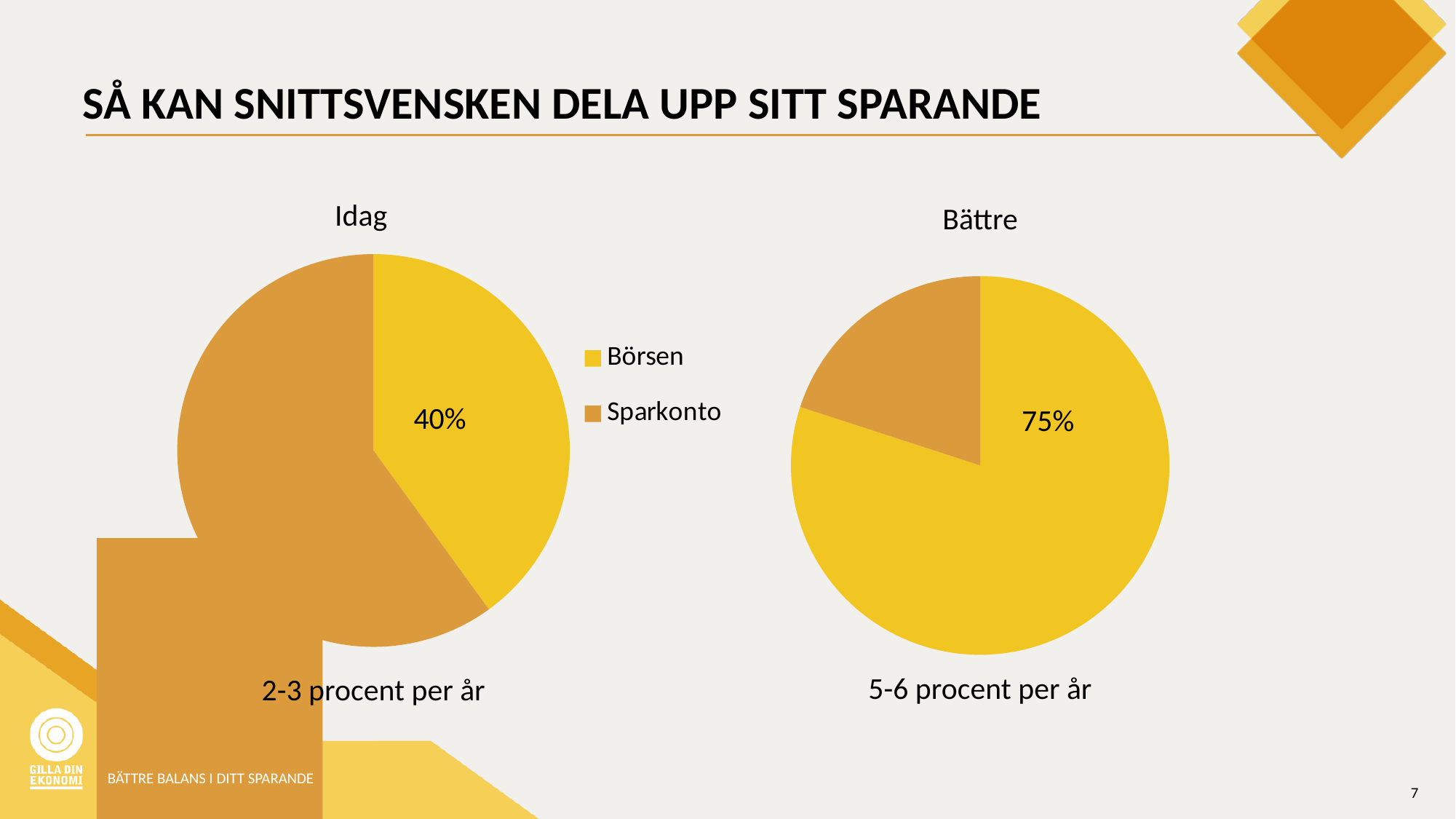
How many categories does the legend list for the pie charts? 2 In the "Bättre" pie chart, which category has the largest slice? Börsen Is the Börsen share larger in the "Idag" chart or in the "Bättre" chart? Bättre In the "Idag" pie chart, which category has the largest slice? Sparkonto By how many percentage points does the Börsen share in the "Bättre" chart exceed the Börsen share in the "Idag" chart? 35 percentage points What kind of chart is the "Bättre" chart? Pie chart In the "Idag" pie chart, what share does Börsen have? 40% In the "Bättre" pie chart, what share does Börsen have? 75% Which category is shown in the darker orange colour in the pie charts? Sparkonto In the "Bättre" pie chart, which category has the smallest slice? Sparkonto In the "Idag" pie chart, which category has the smallest slice? Börsen What kind of chart is the "Idag" chart? Pie chart